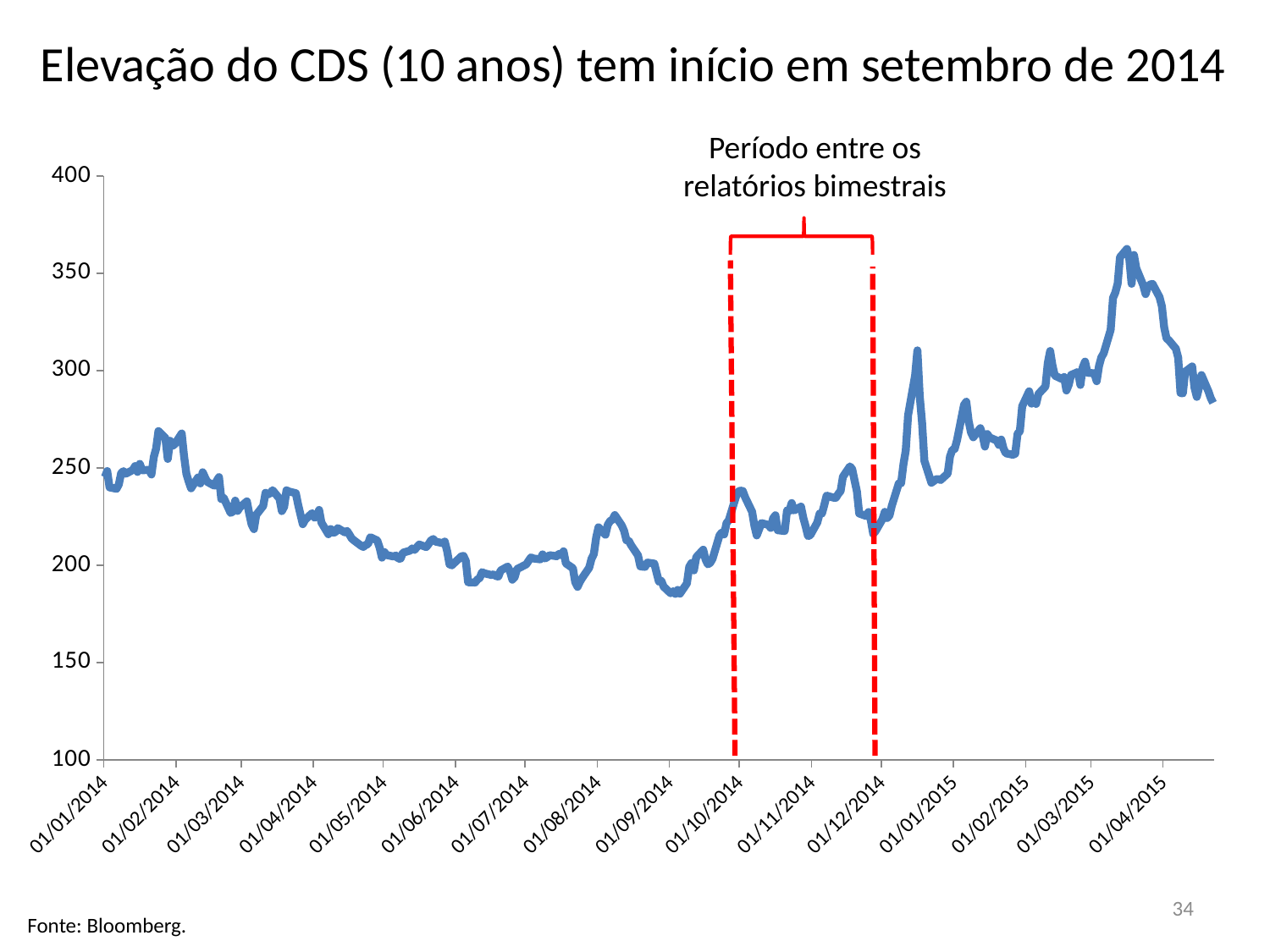
Does the line generally rise or fall between 01/01/2014 and 01/09/2014? fall Is the value at 01/04/2014 greater or less than 250? less How many date labels are shown on the x axis? 16 Is the value at 01/09/2014 greater or less than 250? less Is the value at 01/01/2014 greater or less than 200? greater Does the line generally rise or fall between 01/09/2014 and 01/04/2015? rise What is the highest value shown on the y axis? 400 What does the red bracket annotation above the dashed lines say? Período entre os relatórios bimestrais What kind of chart is shown on the slide? line chart What is the title of the slide's chart? Elevação do CDS (10 anos) tem início em setembro de 2014